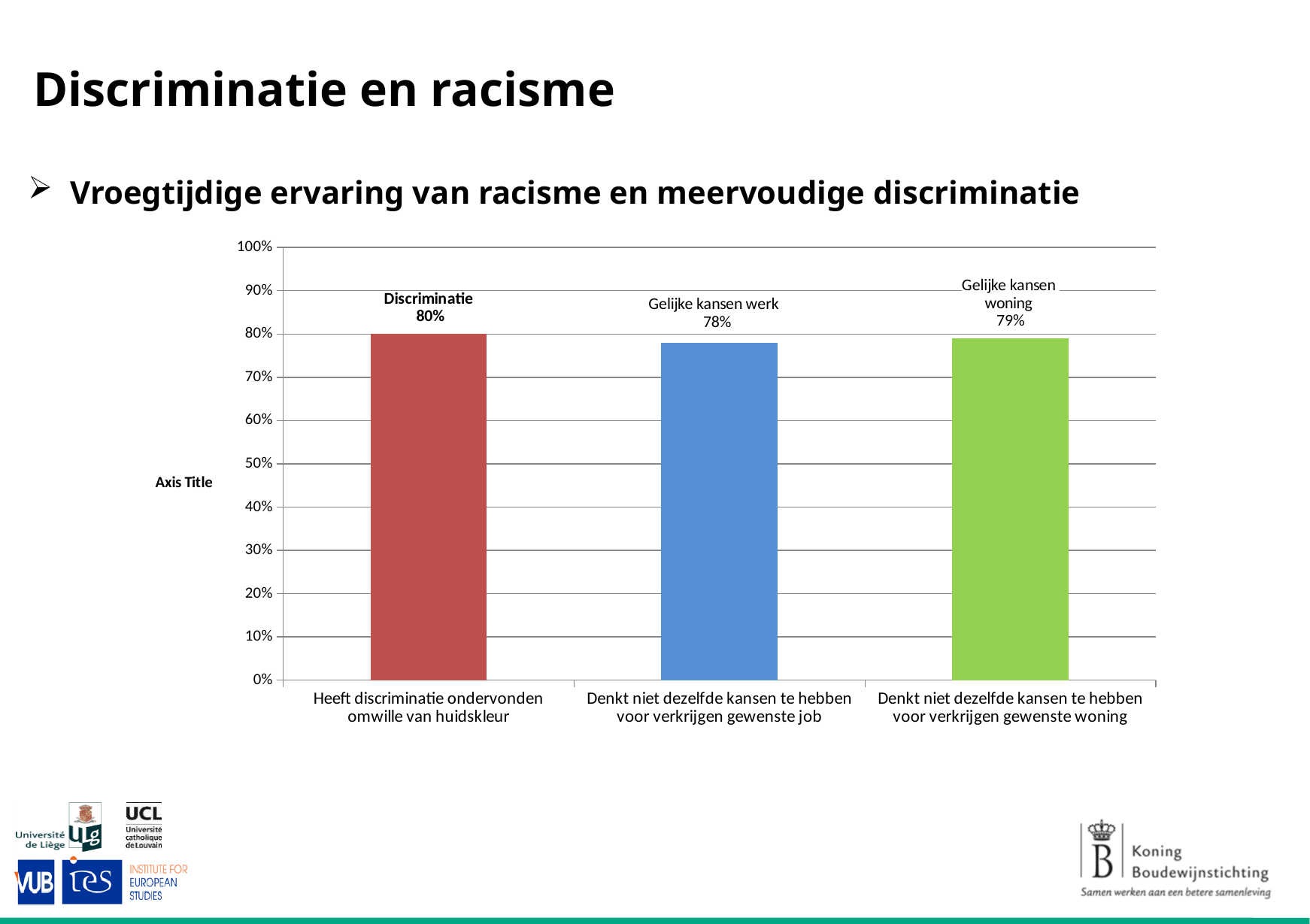
What is the value for the category "Denkt niet dezelfde kansen te hebben voor verkrijgen gewenste job"? 78% What value is shown for the bar labelled "Gelijke kansen werk"? 78% What is the difference between the "Discriminatie" value and the "Gelijke kansen werk" value? 2% Which is larger according to the data labels: "Gelijke kansen woning" or "Gelijke kansen werk"? Gelijke kansen woning What value is shown for the bar labelled "Discriminatie"? 80% What type of chart is shown on the slide? Bar chart Which bar has the highest value according to the data labels? Discriminatie (80%) What is the label shown on the vertical axis of the chart? Axis Title Is the value for "Heeft discriminatie ondervonden omwille van huidskleur" greater or less than 50%? greater Which bar has the lowest value according to the data labels? Gelijke kansen werk (78%) What value is shown for the bar labelled "Gelijke kansen woning"? 79% How many bars are plotted in the chart? 3